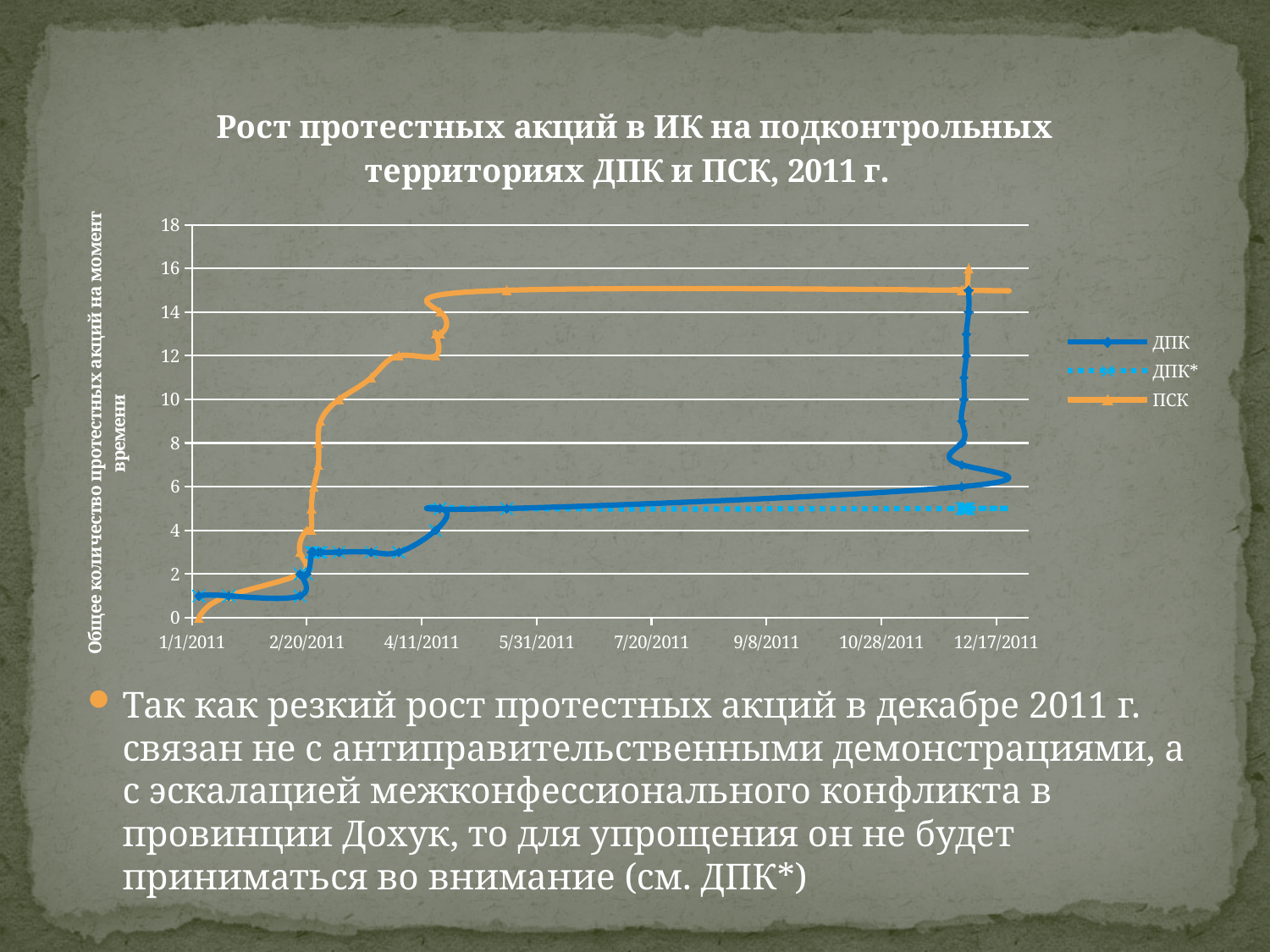
How many date labels are shown on the x axis? 8 Does the ПСК series rise or fall over the course of 2011? rise Which series has the lowest value at the end of the period (12/17/2011)? ДПК* How many series does the legend list? 3 Is the value of ПСК at 7/20/2011 greater or less than 14? greater At 9/8/2011, which series has the larger value, ПСК or ДПК*? ПСК What are the three series named in the legend? ДПК, ДПК*, ПСК Is the value of ДПК* at 9/8/2011 greater or less than 6? less Which series is drawn with a dashed line? ДПК* Is the value of ДПК at 12/17/2011 greater or less than 10? greater What kind of chart is shown on the slide? line chart